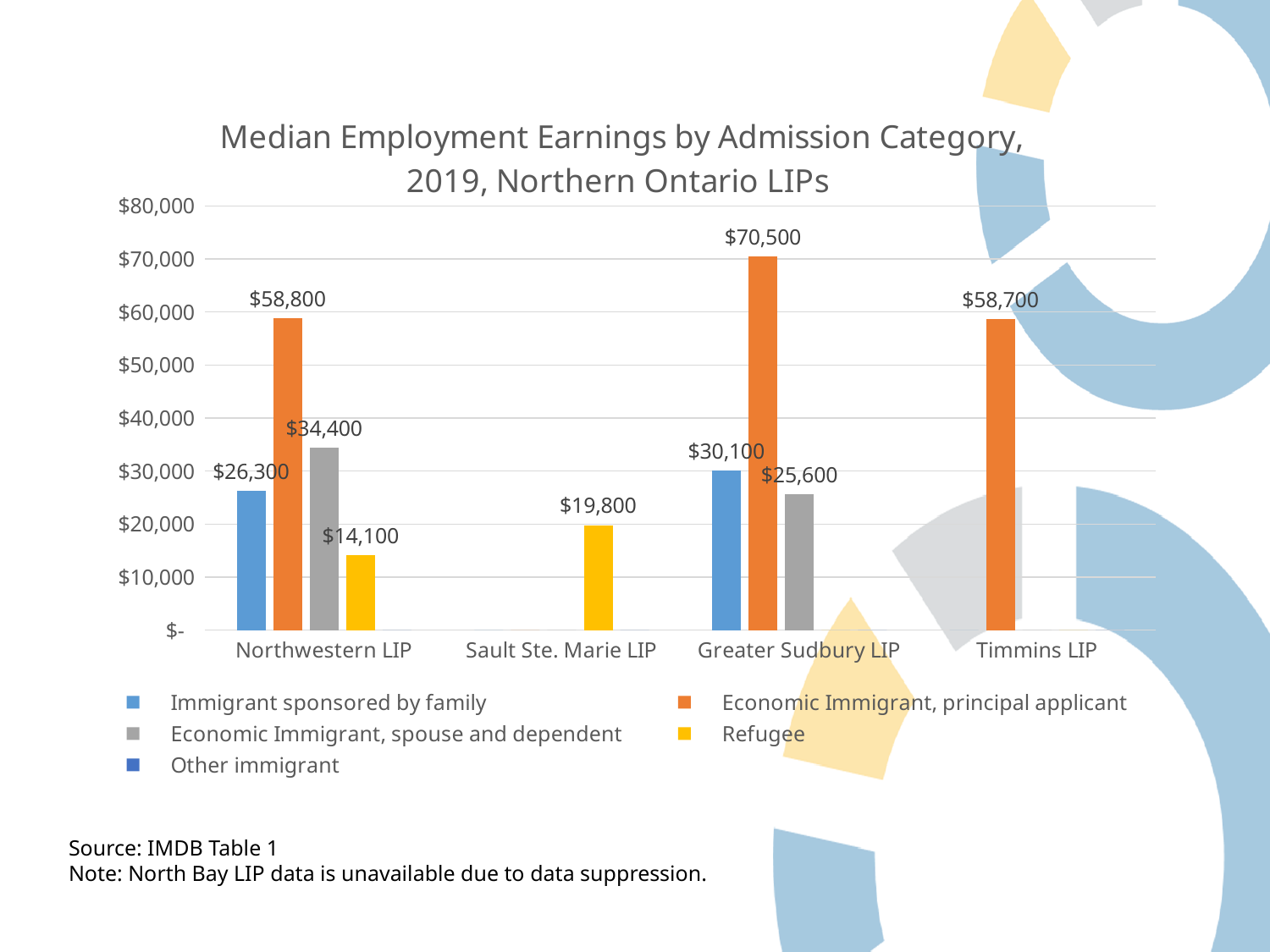
What type of chart is shown on the slide? Bar chart What is the median employment earnings for Refugee in Sault Ste. Marie LIP? $19,800 What is the median employment earnings for Immigrant sponsored by family in Northwestern LIP? $26,300 What is the difference between the Economic Immigrant, principal applicant earnings in Northwestern LIP and Timmins LIP? $100 Which LIP has the highest median employment earnings for Economic Immigrant, principal applicant? Greater Sudbury LIP How many admission categories does the legend list? 5 Which LIP has higher median earnings for Immigrant sponsored by family, Northwestern LIP or Greater Sudbury LIP? Greater Sudbury LIP What is the median employment earnings for Economic Immigrant, spouse and dependent in Greater Sudbury LIP? $25,600 Which admission category has the lowest median employment earnings in Northwestern LIP? Refugee In Greater Sudbury LIP, how much higher are the earnings for Economic Immigrant, principal applicant than for Immigrant sponsored by family? $40,400 How many LIPs are shown on the x axis of the chart? 4 What is the median employment earnings for Economic Immigrant, principal applicant in Greater Sudbury LIP? $70,500